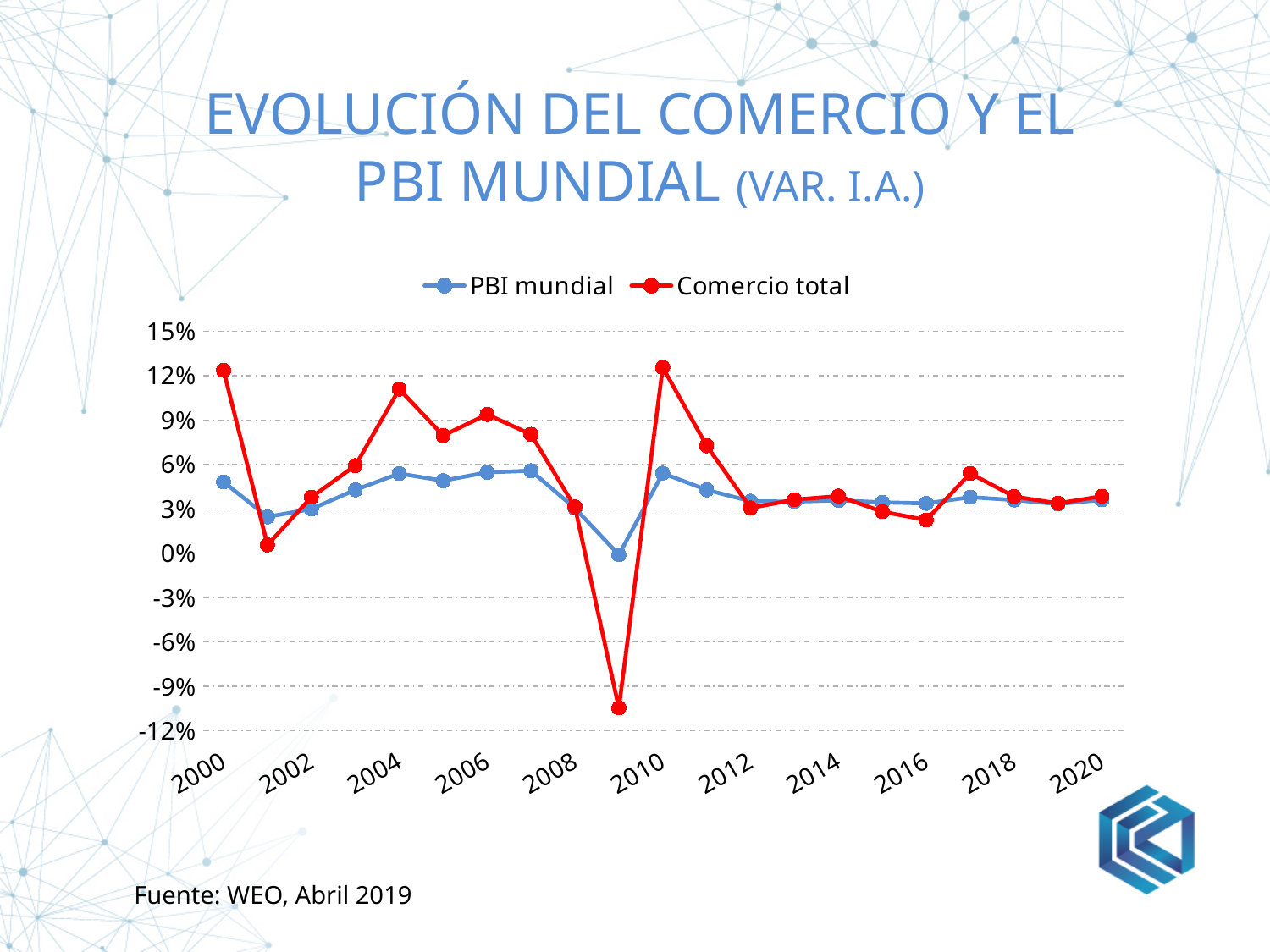
Is the value of PBI mundial in 2009 greater or less than 3%? less Is the value of Comercio total in 2009 greater or less than -9%? less In 2004, which series has the higher value, PBI mundial or Comercio total? Comercio total What kind of chart is shown on the slide? Line chart Is the value of Comercio total in 2001 greater or less than 3%? less What source is cited below the chart? WEO, Abril 2019 Which series is drawn in red? Comercio total In which year does PBI mundial reach its lowest value? 2009 How many series does the legend list? 2 In which year does Comercio total reach its lowest value? 2009 Does Comercio total rise or fall from 2010 to 2012? Fall